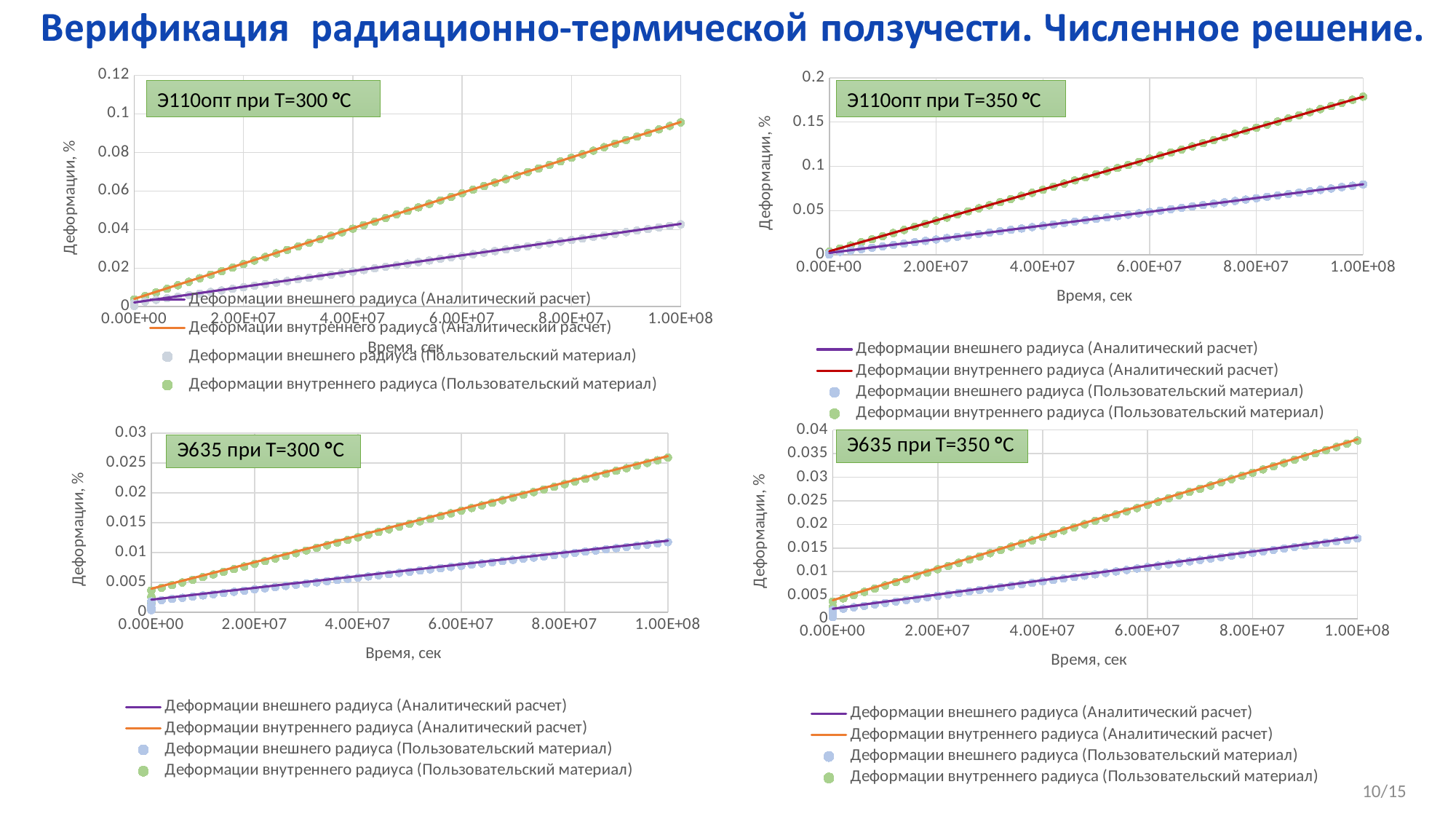
In the chart titled 'Э110опт при T=350 °C', is the value of 'Деформации внутреннего радиуса (Аналитический расчет)' at 1.00E+08 greater or less than 0.15? greater In the chart titled 'Э110опт при T=300 °C', what kind of chart is it? line chart In the chart titled 'Э110опт при T=350 °C', do the deformation values rise or fall as time increases along the x axis? rise In the chart titled 'Э635 при T=300 °C', is the value of 'Деформации внешнего радиуса (Аналитический расчет)' at 1.00E+08 greater or less than 0.015? less In the chart titled 'Э110опт при T=300 °C', is the value of 'Деформации внешнего радиуса (Аналитический расчет)' at 1.00E+08 greater or less than 0.06? less In the chart titled 'Э635 при T=350 °C', how many series does the legend list? 4 How many charts are shown on the slide? 4 In the chart titled 'Э635 при T=300 °C', what is the label of the y axis? Деформации, % In the chart titled 'Э110опт при T=350 °C', what is the label of the x axis? Время, сек In the chart titled 'Э635 при T=350 °C', which series is higher at 1.00E+08: 'Деформации внутреннего радиуса (Аналитический расчет)' or 'Деформации внешнего радиуса (Аналитический расчет)'? Деформации внутреннего радиуса (Аналитический расчет)